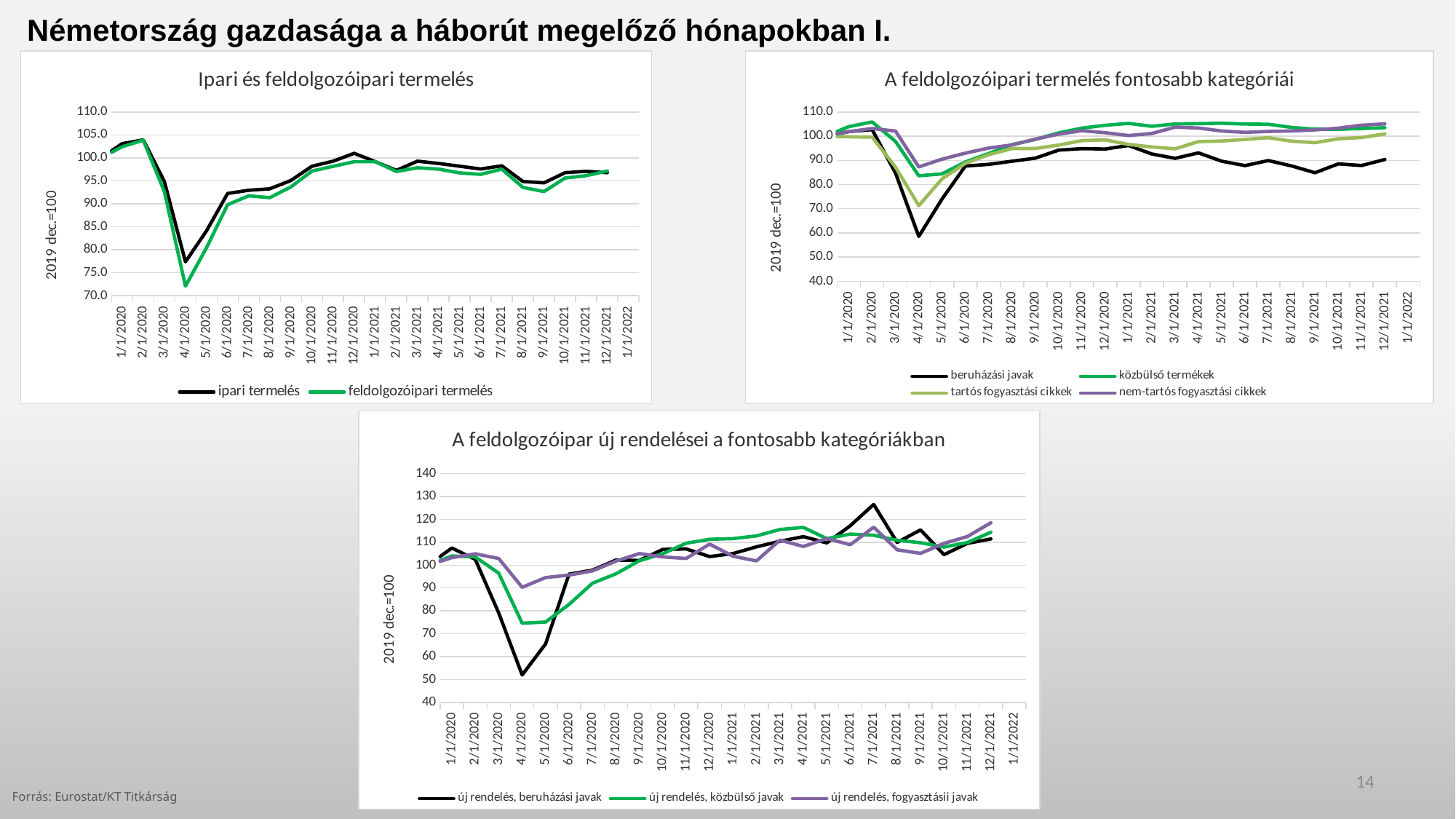
How many series does the legend of the chart titled "A feldolgozóipar új rendelései a fontosabb kategóriákban" list? 3 How many series does the legend of the chart titled "A feldolgozóipari termelés fontosabb kategóriái" list? 4 In the chart titled "A feldolgozóipar új rendelései a fontosabb kategóriákban", is the value of új rendelés, beruházási javak at 4/1/2020 greater or less than 60? less In the chart titled "Ipari és feldolgozóipari termelés", is the value of feldolgozóipari termelés at 4/1/2020 greater or less than 75.0? less In the chart titled "A feldolgozóipari termelés fontosabb kategóriái", is the value of beruházási javak at 4/1/2020 greater or less than 70.0? less How many charts are shown on the slide? 3 In the chart titled "Ipari és feldolgozóipari termelés", which series is higher at 4/1/2020, ipari termelés or feldolgozóipari termelés? ipari termelés What kind of chart is the chart titled "Ipari és feldolgozóipari termelés"? line chart In the chart titled "Ipari és feldolgozóipari termelés", at which date does the feldolgozóipari termelés series reach its lowest value? 4/1/2020 In the chart titled "A feldolgozóipari termelés fontosabb kategóriái", which series has the lowest value at 4/1/2020? beruházási javak